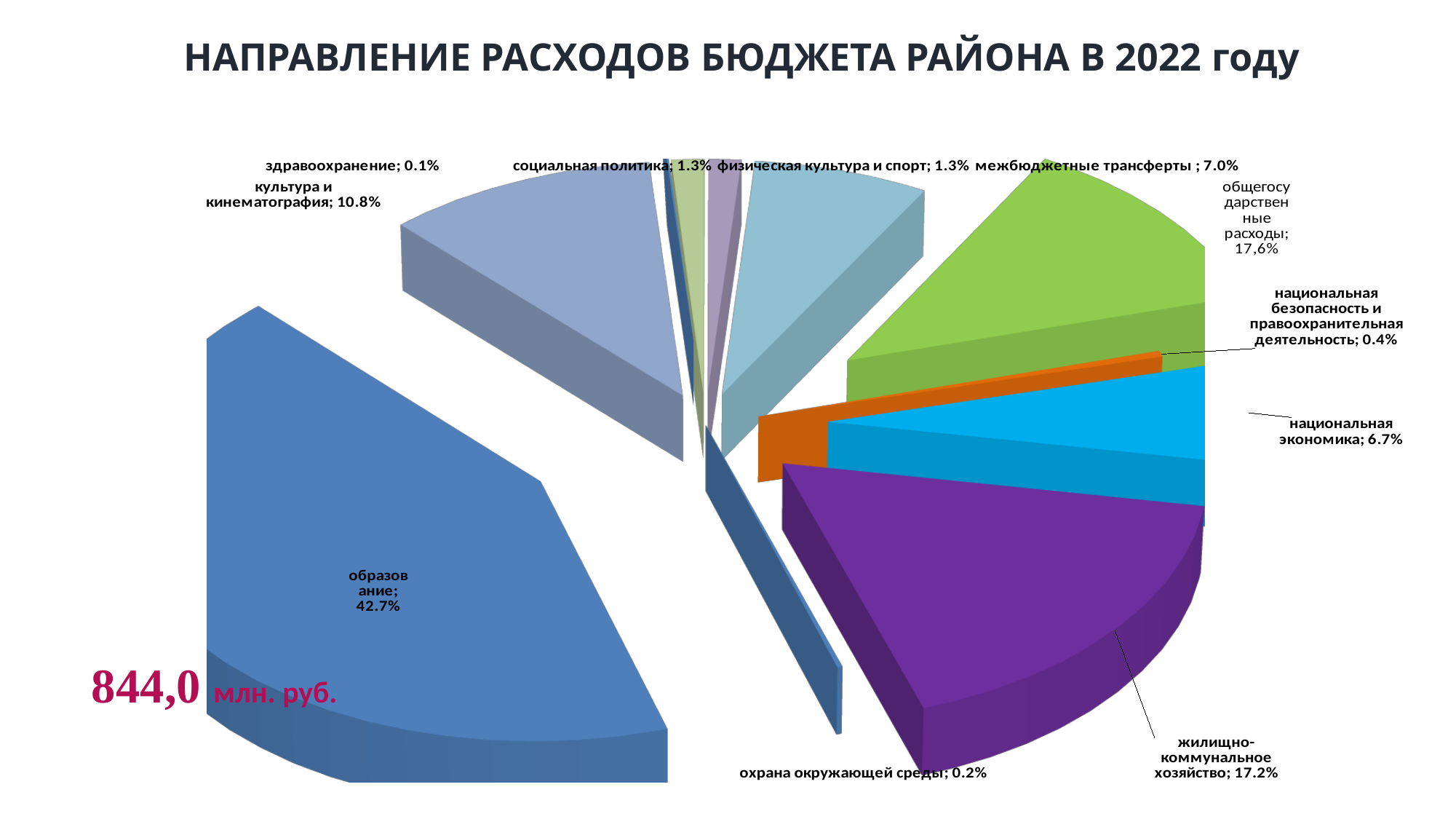
What is the difference between the shares of образование and жилищно-коммунальное хозяйство? 25.5% What share of the budget expenditure goes to образование? 42.7% Which category has the largest share of the pie? образование What share is shown for межбюджетные трансферты? 7.0% What kind of chart is shown on the slide? pie chart How many categories are shown in the pie chart? 11 Which is larger: the share for культура и кинематография or the share for национальная экономика? культура и кинематография What share is shown for общегосударственные расходы? 17,6% What share is shown for жилищно-коммунальное хозяйство? 17.2% Which category has the smallest share of the pie? здравоохранение What share is shown for национальная экономика? 6.7% What is the title of the chart? НАПРАВЛЕНИЕ РАСХОДОВ БЮДЖЕТА РАЙОНА В 2022 году